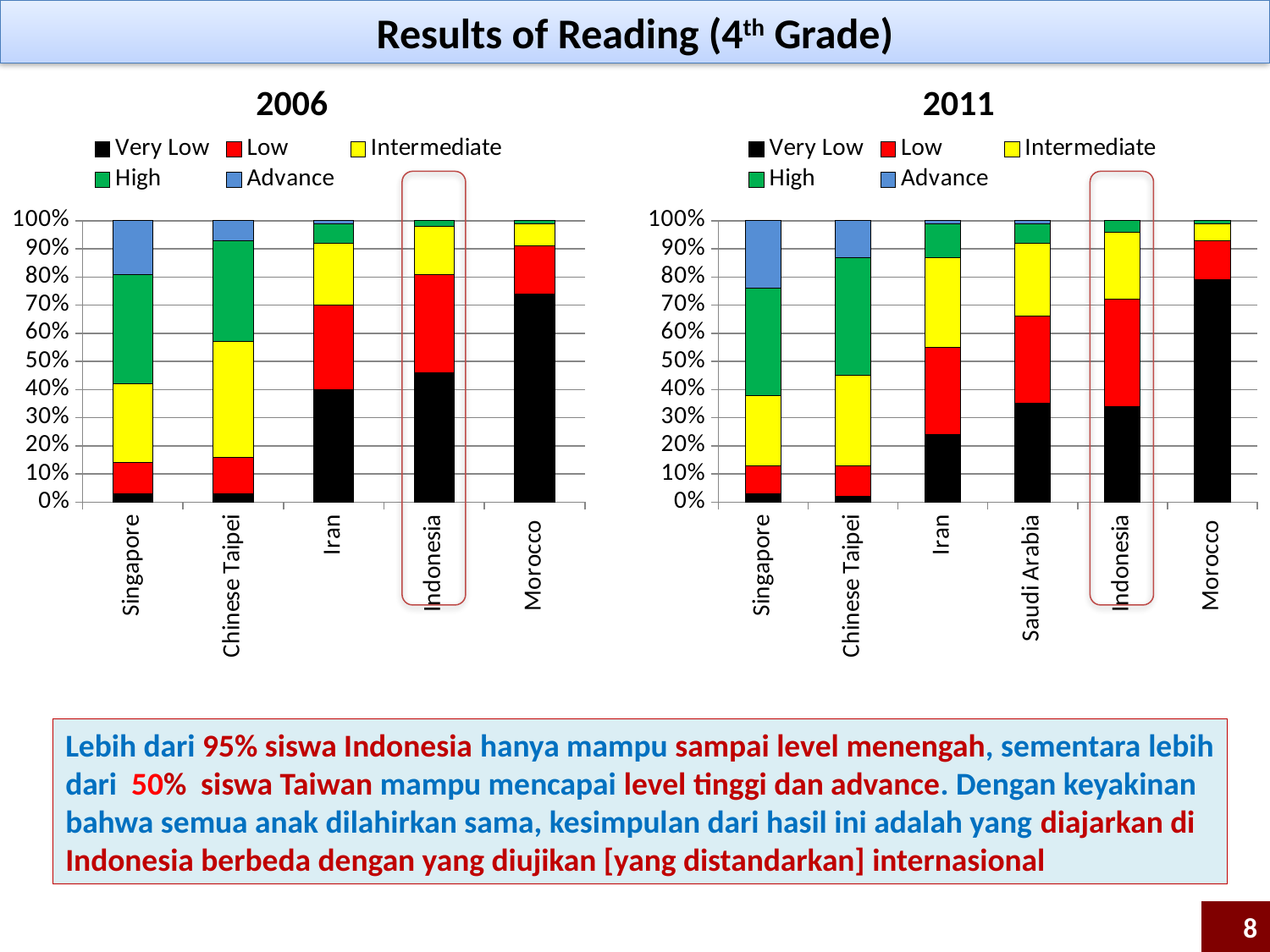
On the 2011 chart, which has the larger Very Low share, Iran or Saudi Arabia? Saudi Arabia On the 2006 chart, does the Very Low share rise or fall from Singapore to Morocco? rise What type of chart is the 2006 chart? Stacked bar chart On the 2006 chart, which country has the largest Very Low share? Morocco On the 2006 chart, is the Very Low share for Morocco greater or less than 60%? greater On the 2011 chart, which country has the largest Advance share? Singapore On the 2006 chart, is the Very Low share for Singapore greater or less than 10%? less Which country is highlighted with a red outline on both charts? Indonesia How many series does the legend of the 2011 chart list? 5 On the 2011 chart, is the Very Low share for Iran greater or less than 30%? less How many countries are shown on the 2006 chart? 5 How many countries are shown on the 2011 chart? 6